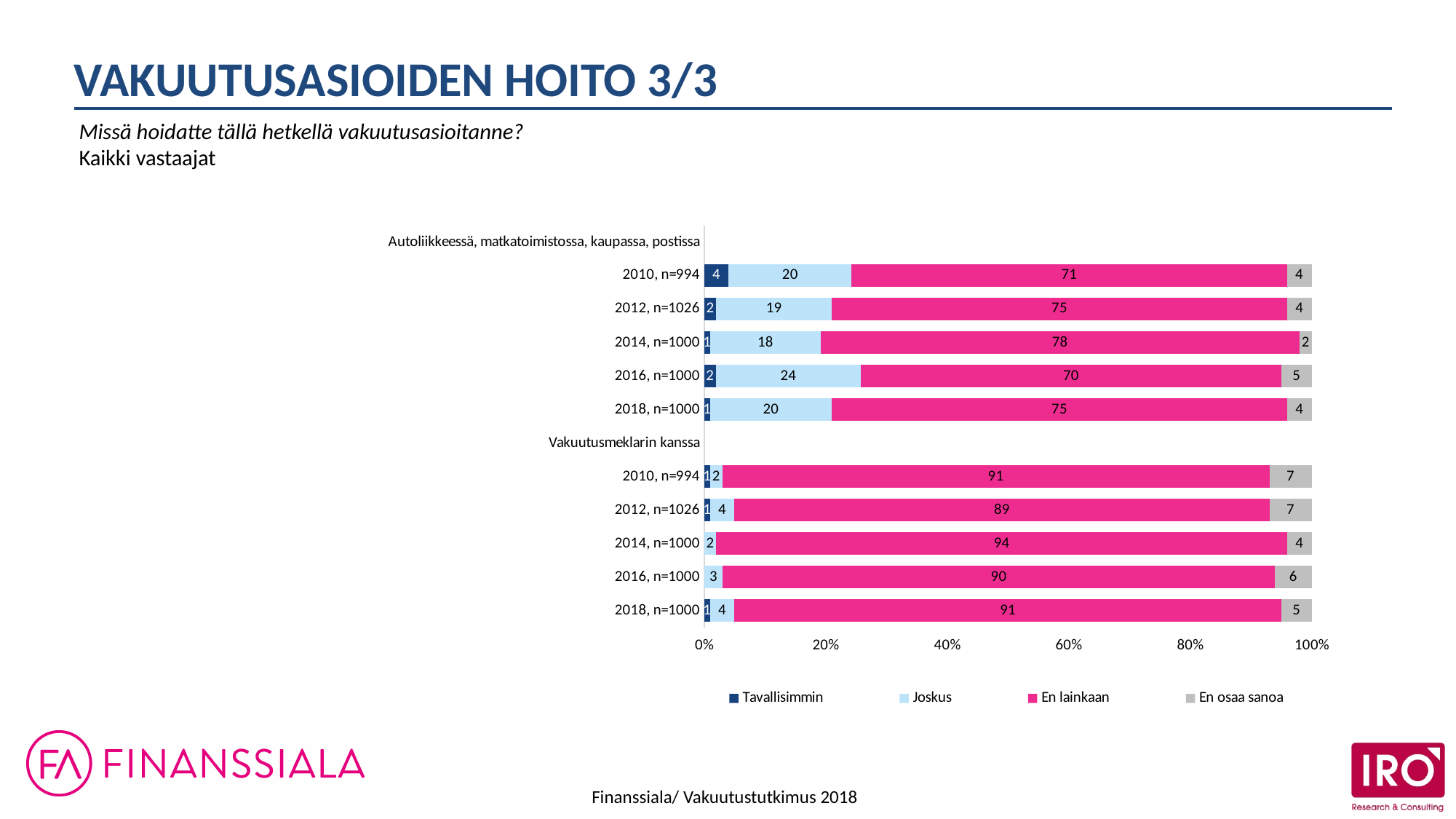
How many bars are plotted in the chart in total? 10 Which legend entry is shown in pink? En lainkaan What kind of chart is shown on the slide? Stacked bar chart What is the difference between the "En lainkaan" values for 2014, n=1000 and 2016, n=1000 in the "Autoliikkeessä, matkatoimistossa, kaupassa, postissa" group? 8 What is the "Joskus" value for 2016, n=1000 in the "Autoliikkeessä, matkatoimistossa, kaupassa, postissa" group? 24 What is the "En osaa sanoa" value for 2010, n=994 in the "Vakuutusmeklarin kanssa" group? 7 What is the "En lainkaan" value for 2012, n=1026 in the "Vakuutusmeklarin kanssa" group? 89 Which is larger: the "Joskus" value for 2010, n=994 or for 2012, n=1026 in the "Autoliikkeessä, matkatoimistossa, kaupassa, postissa" group? 2010, n=994 How many series does the legend list? 4 In the "Vakuutusmeklarin kanssa" group, which year has the lowest "En lainkaan" value? 2012, n=1026 In the "Autoliikkeessä, matkatoimistossa, kaupassa, postissa" group, which year has the highest "En lainkaan" value? 2014, n=1000 What is the "En lainkaan" value for 2014, n=1000 in the "Autoliikkeessä, matkatoimistossa, kaupassa, postissa" group? 78